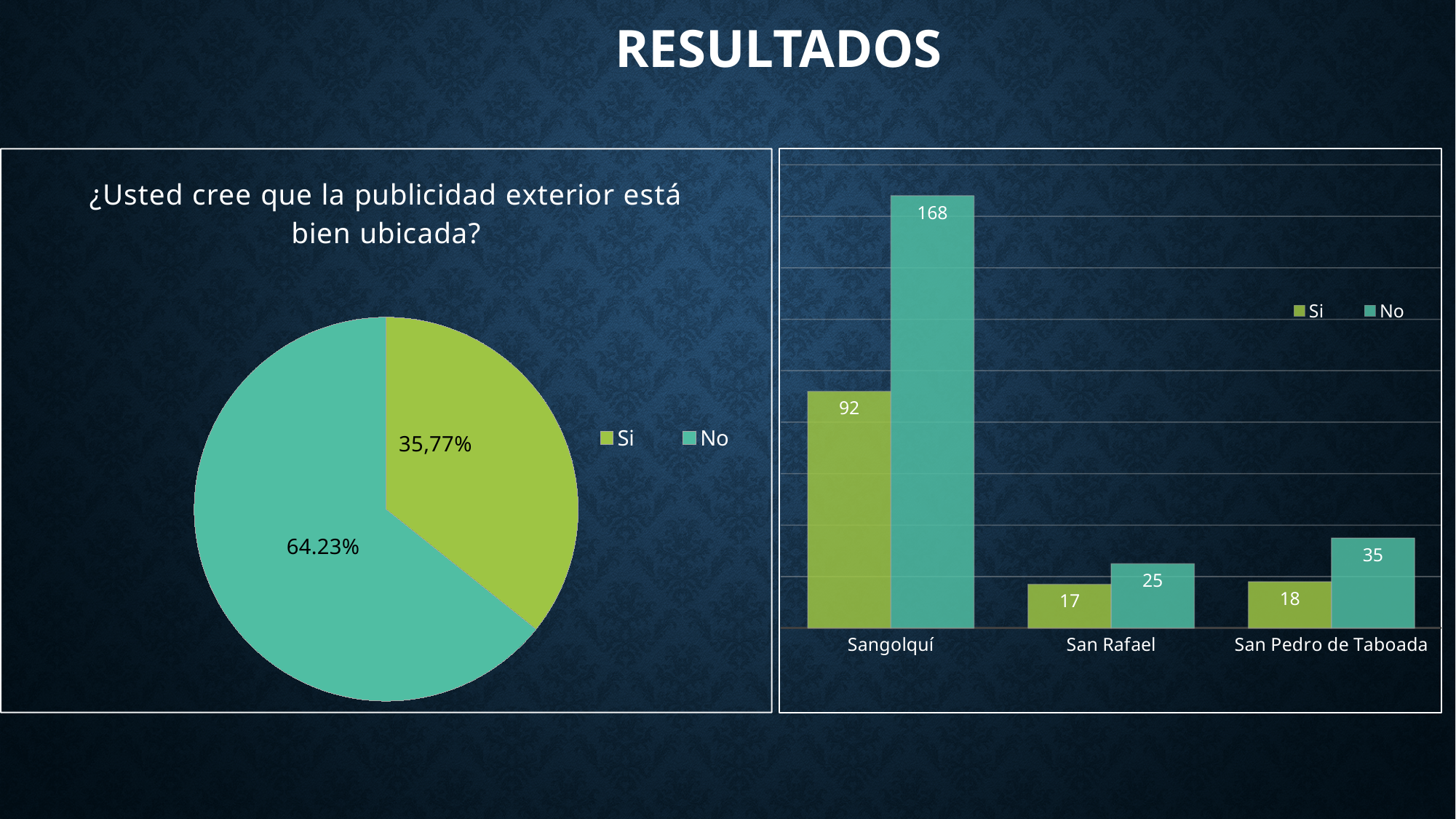
In the bar chart on the right, what is the value of 'No' for Sangolquí? 168 In the bar chart on the right, what is the value of 'Si' for San Rafael? 17 In the bar chart on the right, which category has the highest 'Si' value? Sangolquí In the bar chart on the right, what is the value of 'No' for San Pedro de Taboada? 35 In the pie chart on the left, what share is labelled for the 'No' slice? 64.23% How many categories are shown on the x axis of the bar chart on the right? 3 In the bar chart on the right, what is the difference between the 'No' and 'Si' values for Sangolquí? 76 What type of chart is shown on the left side of the slide? Pie chart How many series does the legend of the bar chart on the right list? 2 What type of chart is shown on the right side of the slide? Bar chart In the pie chart on the left, which slice is larger, 'Si' or 'No'? No In the pie chart on the left, what share is labelled for the 'Si' slice? 35,77%